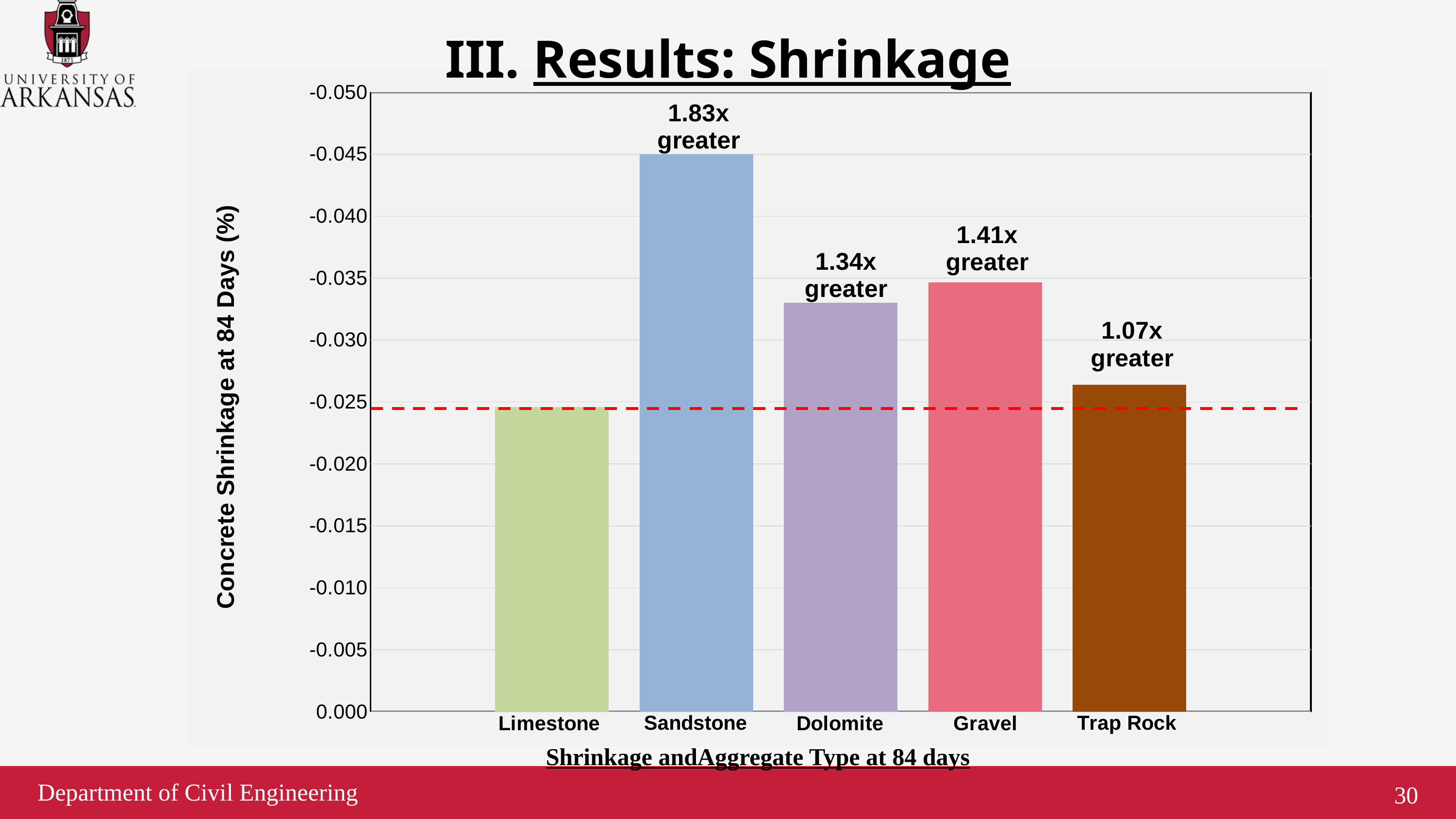
What kind of chart is shown on the slide? bar chart What label is printed above the Dolomite bar? 1.34x greater What label is printed above the Sandstone bar? 1.83x greater Which has the larger shrinkage magnitude, Gravel or Dolomite? Gravel How many aggregate types are plotted on the chart? 5 Is the shrinkage magnitude for Trap Rock greater or less than 0.030? less Is the shrinkage magnitude for Sandstone greater or less than 0.040? greater What label is printed above the Gravel bar? 1.41x greater What label is printed above the Trap Rock bar? 1.07x greater Which aggregate type has the smallest concrete shrinkage at 84 days? Limestone Which aggregate type has the largest concrete shrinkage at 84 days? Sandstone What is the title of the vertical axis? Concrete Shrinkage at 84 Days (%)